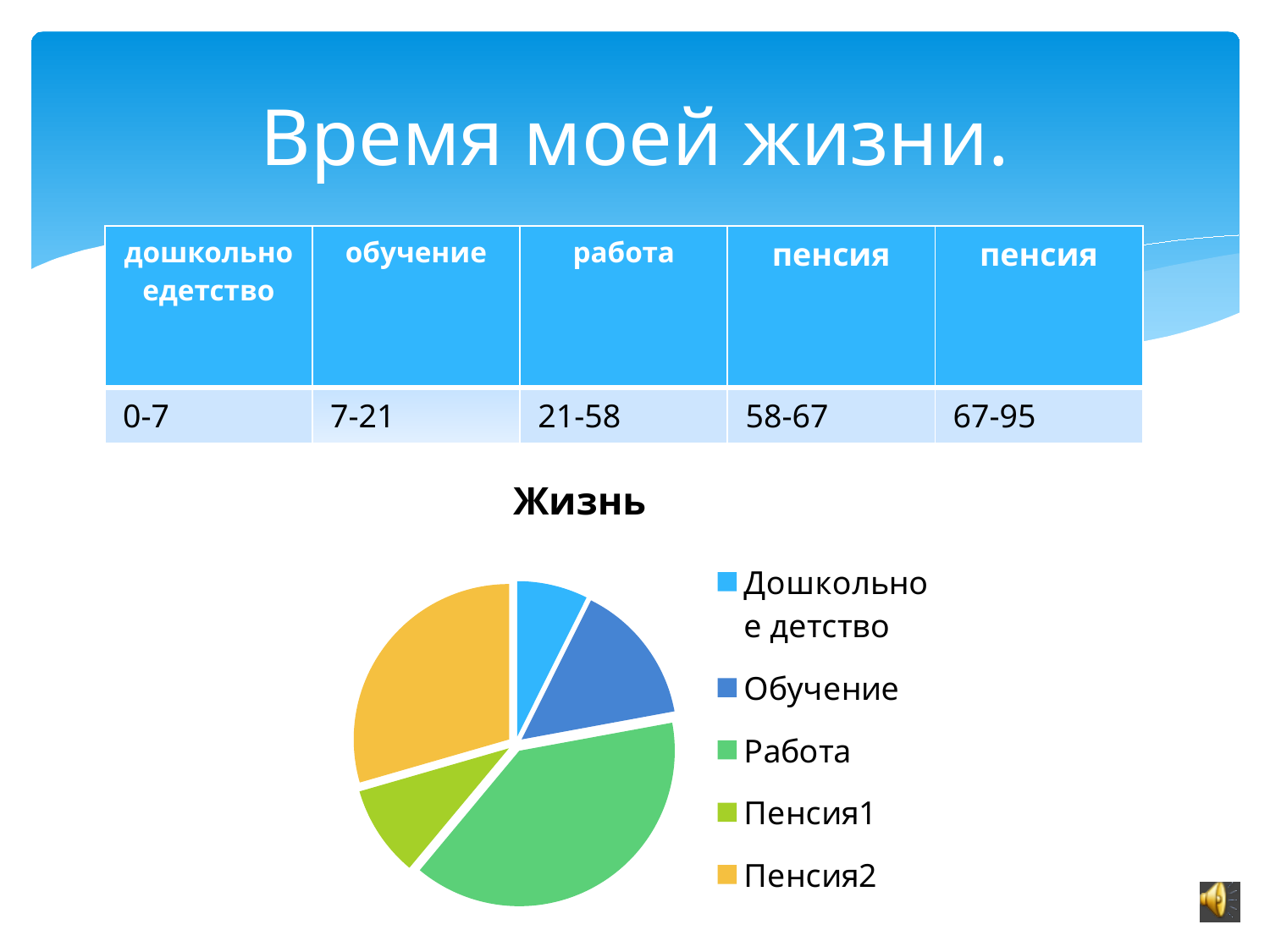
Which category has the largest slice in the pie chart? Работа How many slices does the pie chart have? 5 Which slice is larger, Пенсия2 or Пенсия1? Пенсия2 How many entries does the chart legend list? 5 Which slice is larger, Обучение or Пенсия2? Пенсия2 Which slice is larger, Обучение or Дошкольное детство? Обучение What colour is the Работа slice in the pie chart? green What is the title of the chart? Жизнь What kind of chart is shown on the slide? pie chart